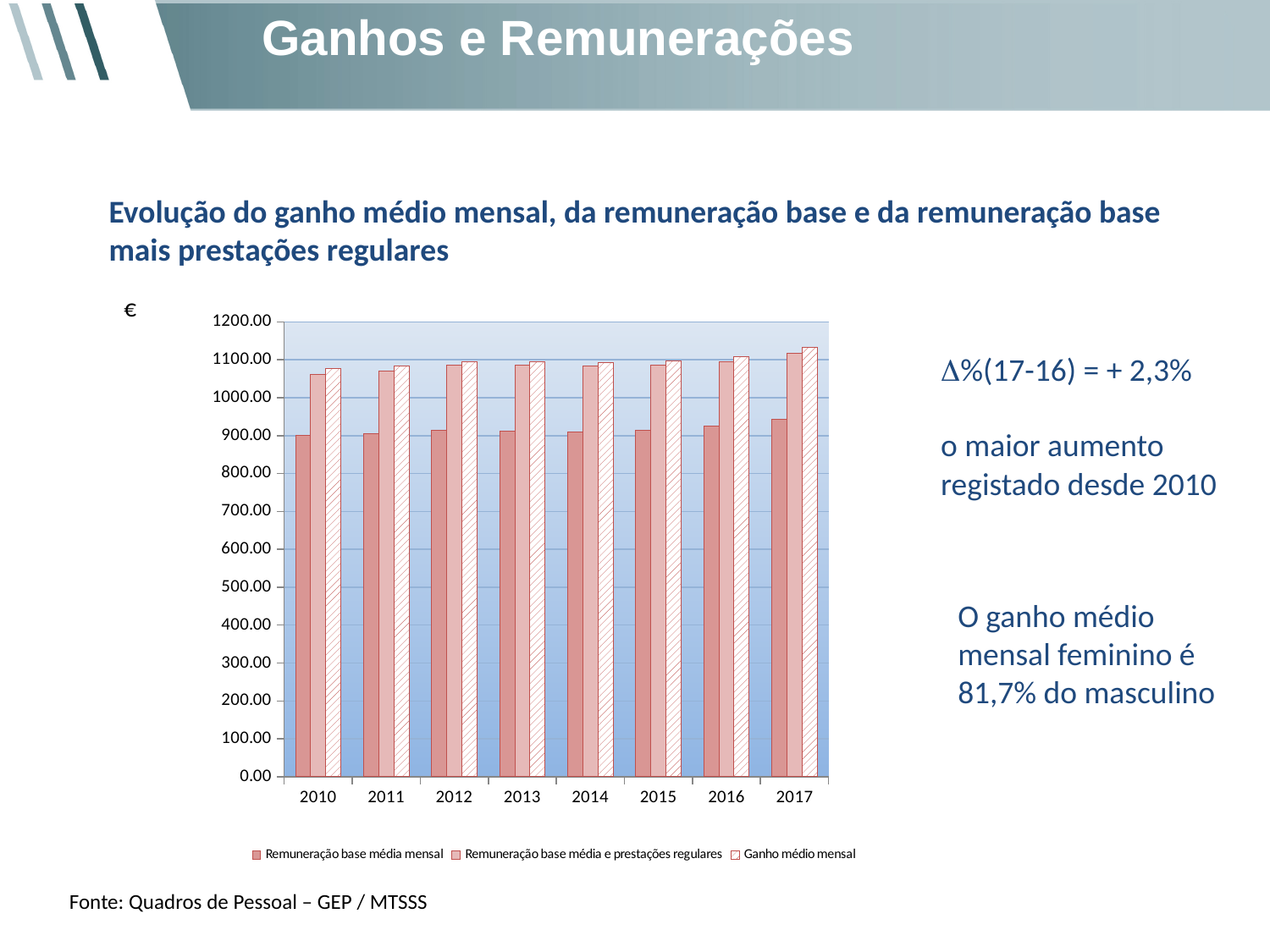
Is the value of Ganho médio mensal in 2017 greater or less than 1100.00? greater What kind of chart is shown on the slide? bar chart Is the value of Ganho médio mensal in 2010 greater or less than 1000.00? greater Which series is shown with hatched (striped) bars in the chart? Ganho médio mensal In which year is Ganho médio mensal highest? 2017 How many series does the chart legend list? 3 Is the value of Remuneração base média mensal in 2010 greater or less than 1000.00? less In 2017, which is larger: Ganho médio mensal or Remuneração base média mensal? Ganho médio mensal Do the values of Ganho médio mensal generally rise or fall from 2010 to 2017? rise What unit is indicated at the top of the chart's vertical axis? € How many years are shown on the x axis of the chart? 8